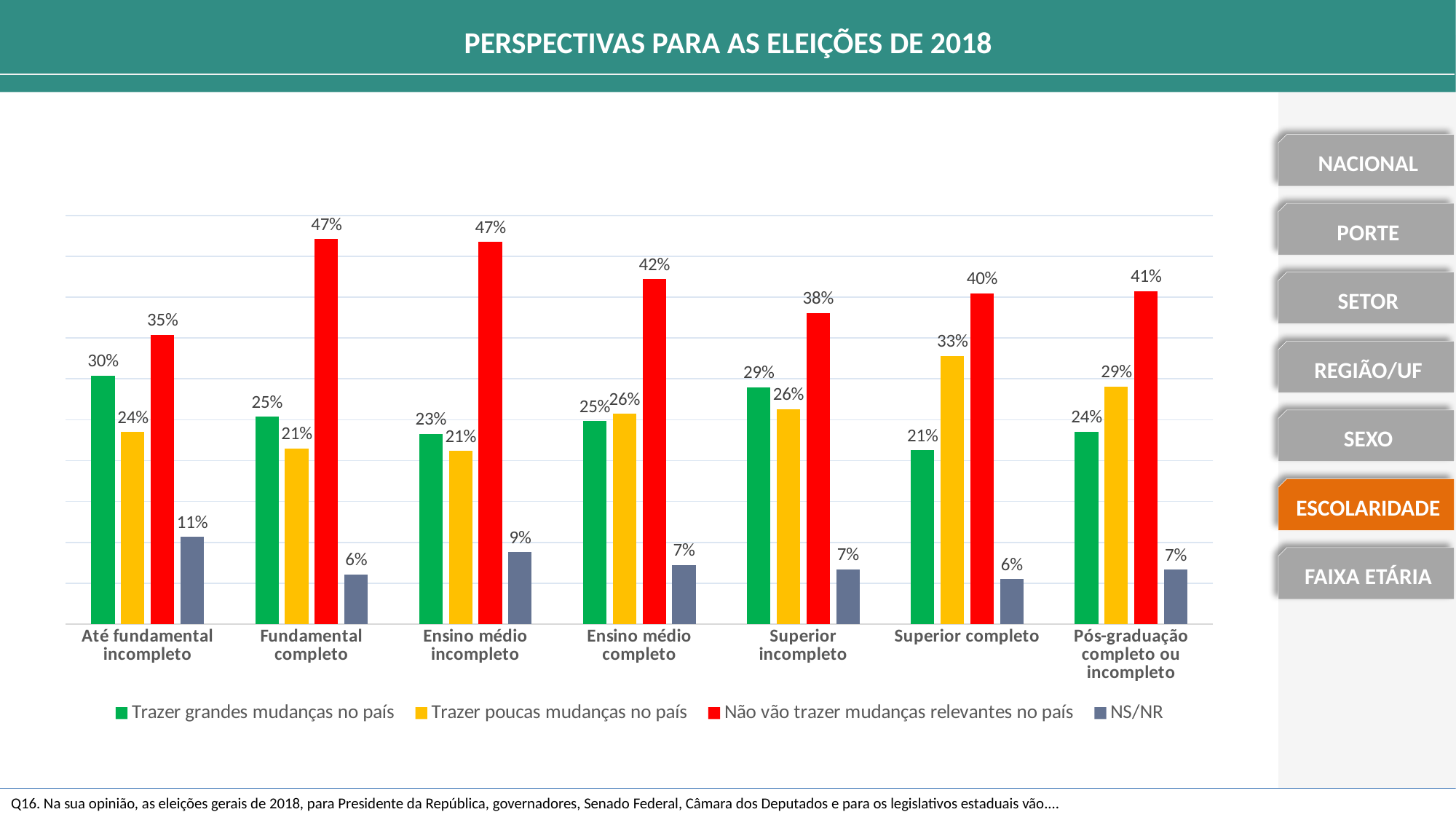
What colour represents "Não vão trazer mudanças relevantes no país" in the chart? Red What is the NS/NR value for Superior completo? 6% What is the value for "Trazer grandes mudanças no país" in the Até fundamental incompleto category? 30% What kind of chart is shown on the slide? Bar chart Which category has the highest value for "Trazer poucas mudanças no país"? Superior completo How many series does the legend list? 4 How many education categories are shown on the x axis? 7 Which category has the lowest value for "Trazer grandes mudanças no país"? Superior completo Which category has the highest NS/NR value? Até fundamental incompleto What is the value for "Não vão trazer mudanças relevantes no país" in the Ensino médio completo category? 42% What is the difference between "Não vão trazer mudanças relevantes no país" and "Trazer grandes mudanças no país" for Fundamental completo? 22% For Superior incompleto, which is larger: "Trazer grandes mudanças no país" or "Trazer poucas mudanças no país"? Trazer grandes mudanças no país